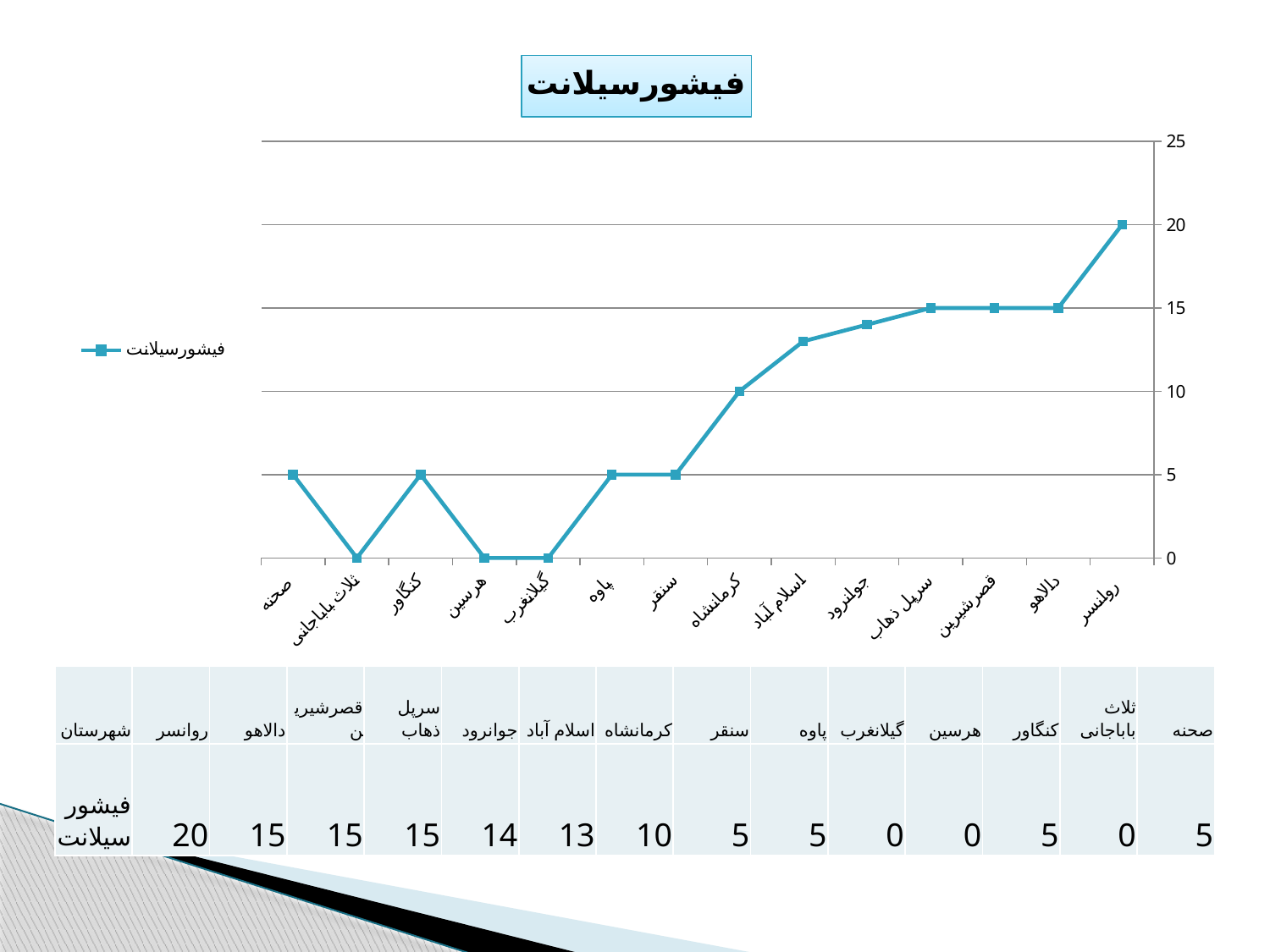
What is the value for روانسر? 20 What is the value for جوانرود? 14 What is the value for کرمانشاه? 10 How many categories are plotted on the x axis? 14 Which is larger, the value for کرمانشاه or the value for سنقر? کرمانشاه What type of chart is shown on the slide? line chart What is the value for اسلام آباد? 13 Is the value for اسلام آباد greater or less than 10? greater Which category has the highest value? روانسر What is the difference between the values for روانسر and دالاهو? 5 What is the title of the chart? فیشورسیلانت How many series does the legend list? 1